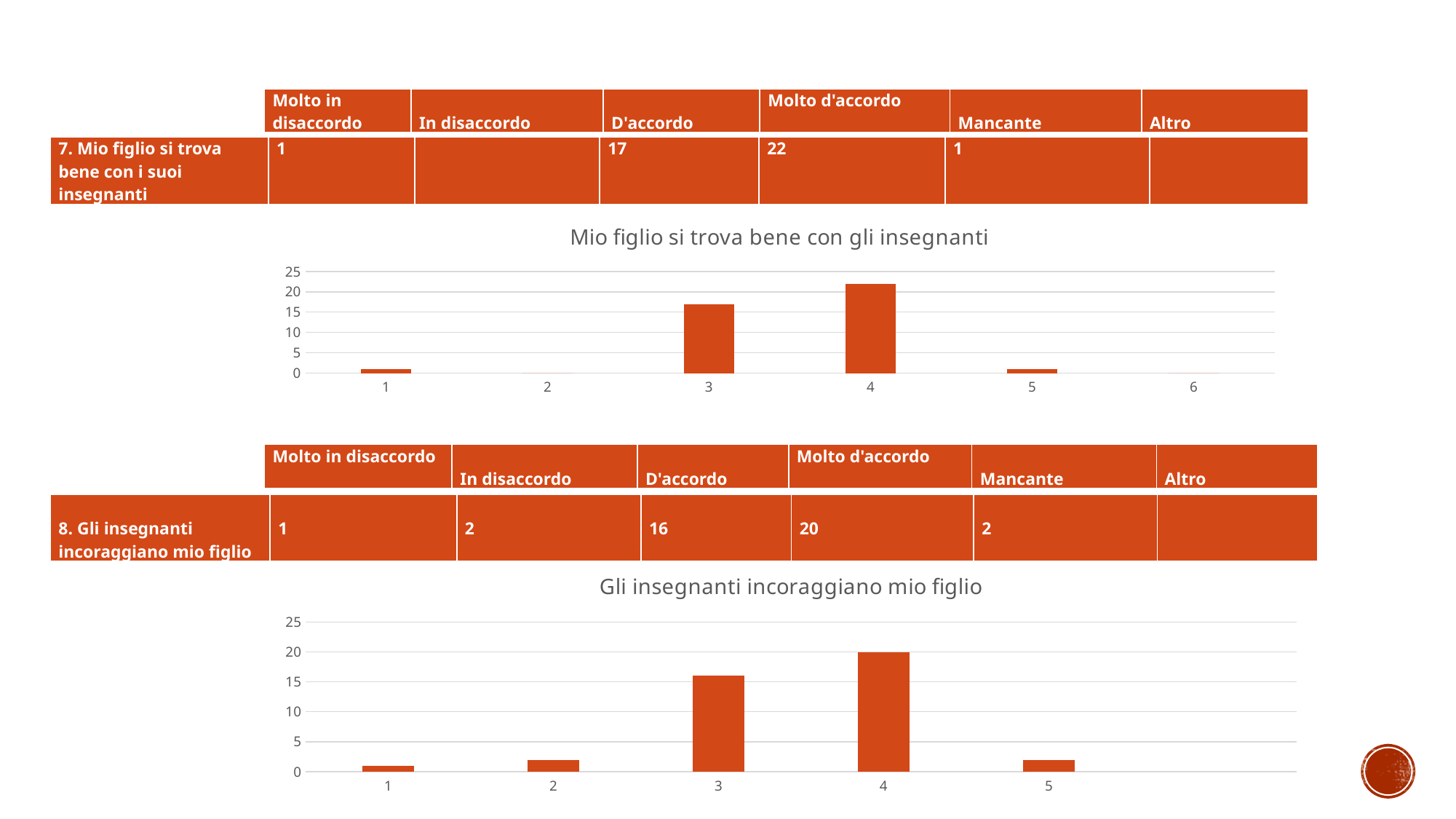
In the top chart "Mio figlio si trova bene con gli insegnanti", which category has the highest bar? 4 What kind of chart is the top chart titled "Mio figlio si trova bene con gli insegnanti"? bar chart In the top chart "Mio figlio si trova bene con gli insegnanti", what is the value for category 4 (Molto d'accordo)? 22 In the bottom chart "Gli insegnanti incoraggiano mio figlio", is the value for category 4 greater or less than 15? greater In the top chart "Mio figlio si trova bene con gli insegnanti", what is the difference between the values for category 4 and category 3? 5 In the top chart "Mio figlio si trova bene con gli insegnanti", is the value for category 3 greater or less than 15? greater How many categories are shown on the x axis of the top chart "Mio figlio si trova bene con gli insegnanti"? 6 What kind of chart is the bottom chart titled "Gli insegnanti incoraggiano mio figlio"? bar chart In the bottom chart "Gli insegnanti incoraggiano mio figlio", what is the value for category 3 (D'accordo)? 16 In the bottom chart "Gli insegnanti incoraggiano mio figlio", which is larger, the value for category 3 or category 4? category 4 In the bottom chart "Gli insegnanti incoraggiano mio figlio", which category has the highest bar? 4 How many categories are shown on the x axis of the bottom chart "Gli insegnanti incoraggiano mio figlio"? 5